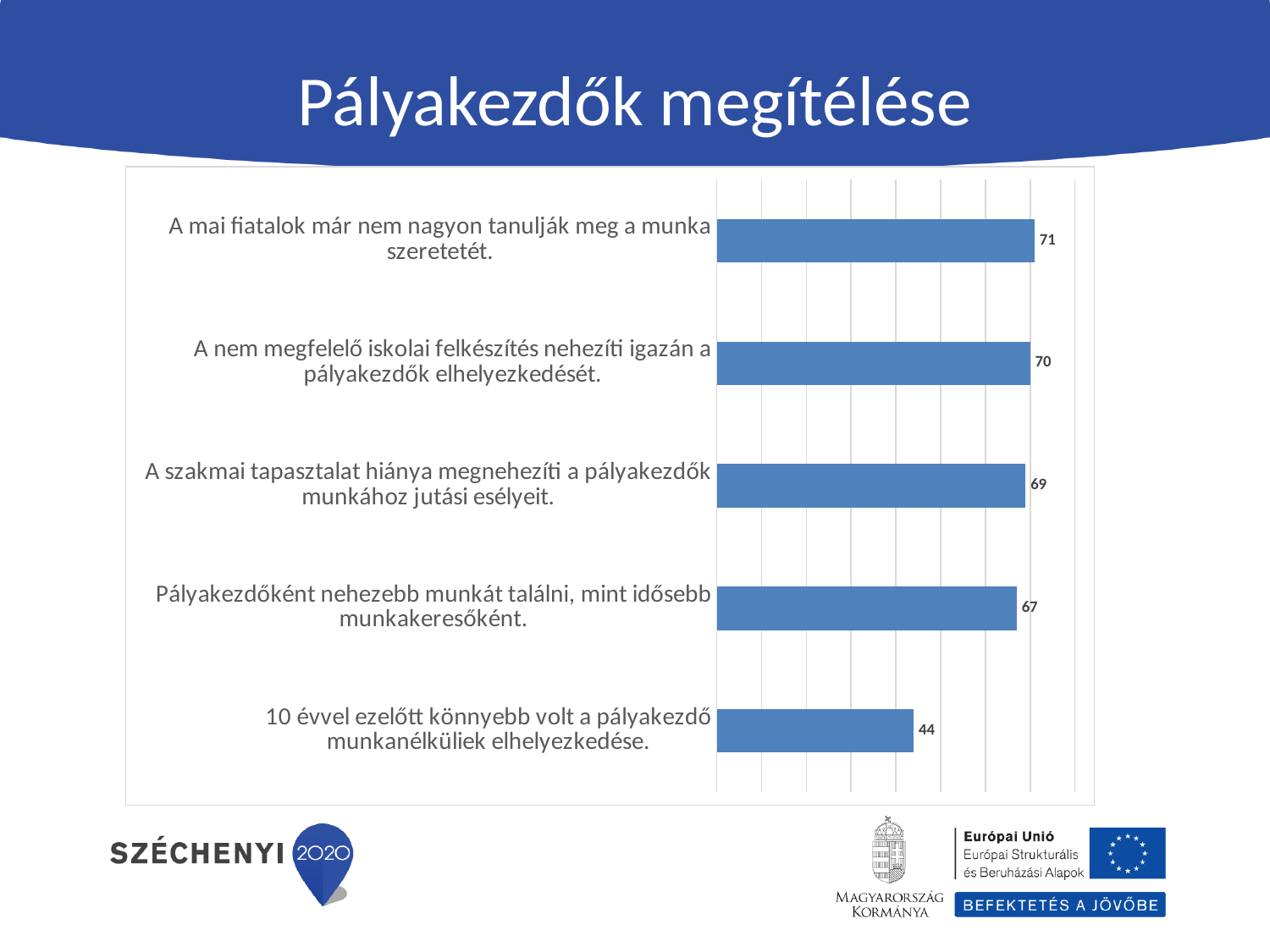
Which statement has the lowest value? 10 évvel ezelőtt könnyebb volt a pályakezdő munkanélküliek elhelyezkedése. What is the value for "A mai fiatalok már nem nagyon tanulják meg a munka szeretetét."? 71 Which statement has the highest value? A mai fiatalok már nem nagyon tanulják meg a munka szeretetét. How many statements (bars) are shown in the chart? 5 What is the value for "A szakmai tapasztalat hiánya megnehezíti a pályakezdők munkához jutási esélyeit."? 69 What is the title of the slide? Pályakezdők megítélése What is the value for "10 évvel ezelőtt könnyebb volt a pályakezdő munkanélküliek elhelyezkedése."? 44 What is the difference between the highest and lowest values in the chart? 27 What is the difference between the value for "A nem megfelelő iskolai felkészítés nehezíti igazán a pályakezdők elhelyezkedését." and the value for "10 évvel ezelőtt könnyebb volt a pályakezdő munkanélküliek elhelyezkedése."? 26 What kind of chart is shown on the slide? Bar chart What is the value for "Pályakezdőként nehezebb munkát találni, mint idősebb munkakeresőként."? 67 Which is larger: the value for "Pályakezdőként nehezebb munkát találni, mint idősebb munkakeresőként." or the value for "10 évvel ezelőtt könnyebb volt a pályakezdő munkanélküliek elhelyezkedése."? Pályakezdőként nehezebb munkát találni, mint idősebb munkakeresőként.